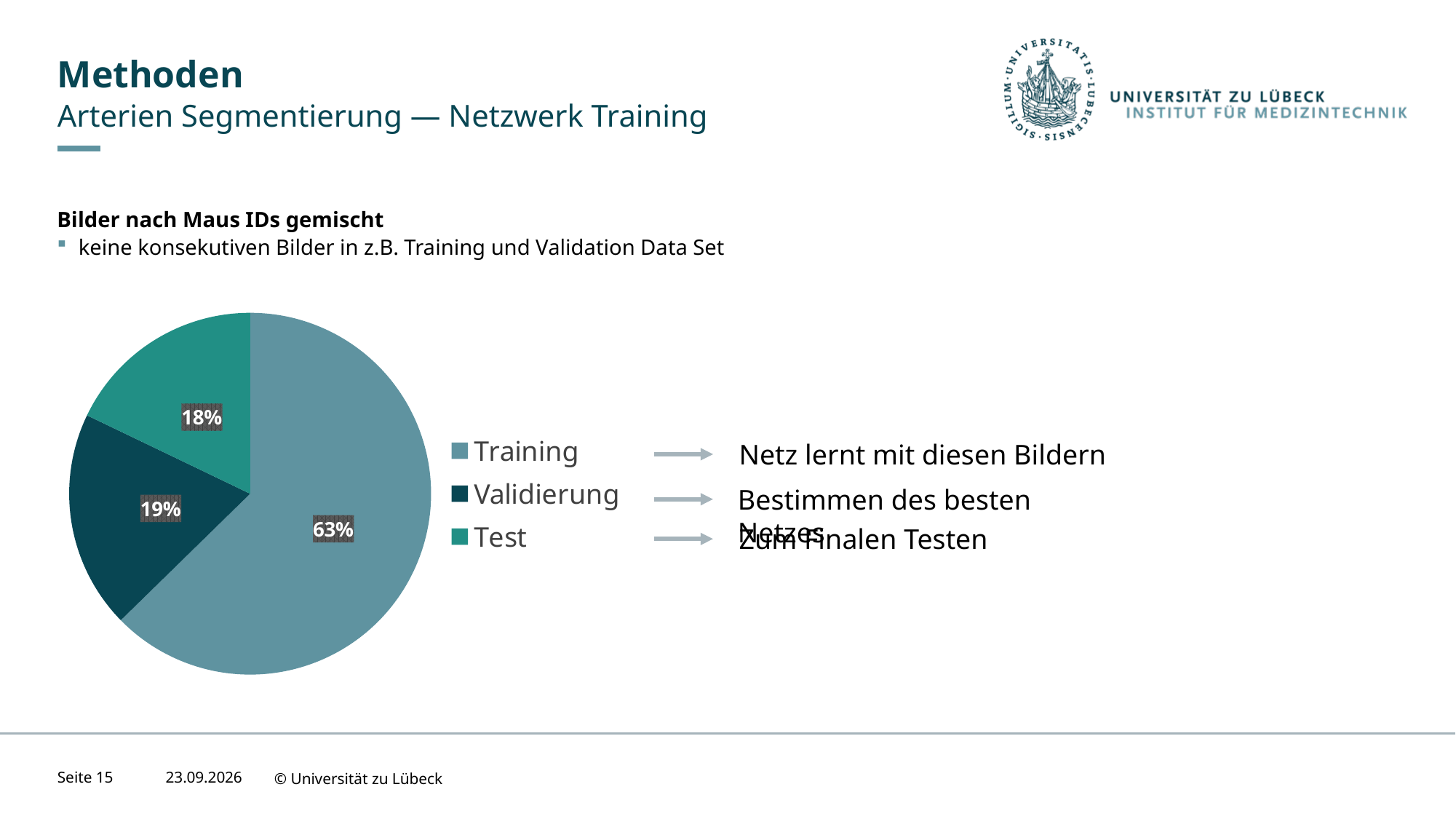
What share of the pie chart does Test account for? 18% What is the difference in percentage points between the Training and Validierung slices? 44 How many slices does the pie chart have? 3 What is the combined share of the Validierung and Test slices? 37% What kind of chart is shown on the slide? Pie chart What share of the pie chart does Validierung account for? 19% What is the difference in percentage points between the Training and Test slices? 45 Which is larger, the Training slice or the Test slice? Training What share of the pie chart does Training account for? 63% How many entries does the legend of the pie chart list? 3 Which legend entry is shown in the darkest colour? Validierung Which category has the largest slice of the pie chart? Training